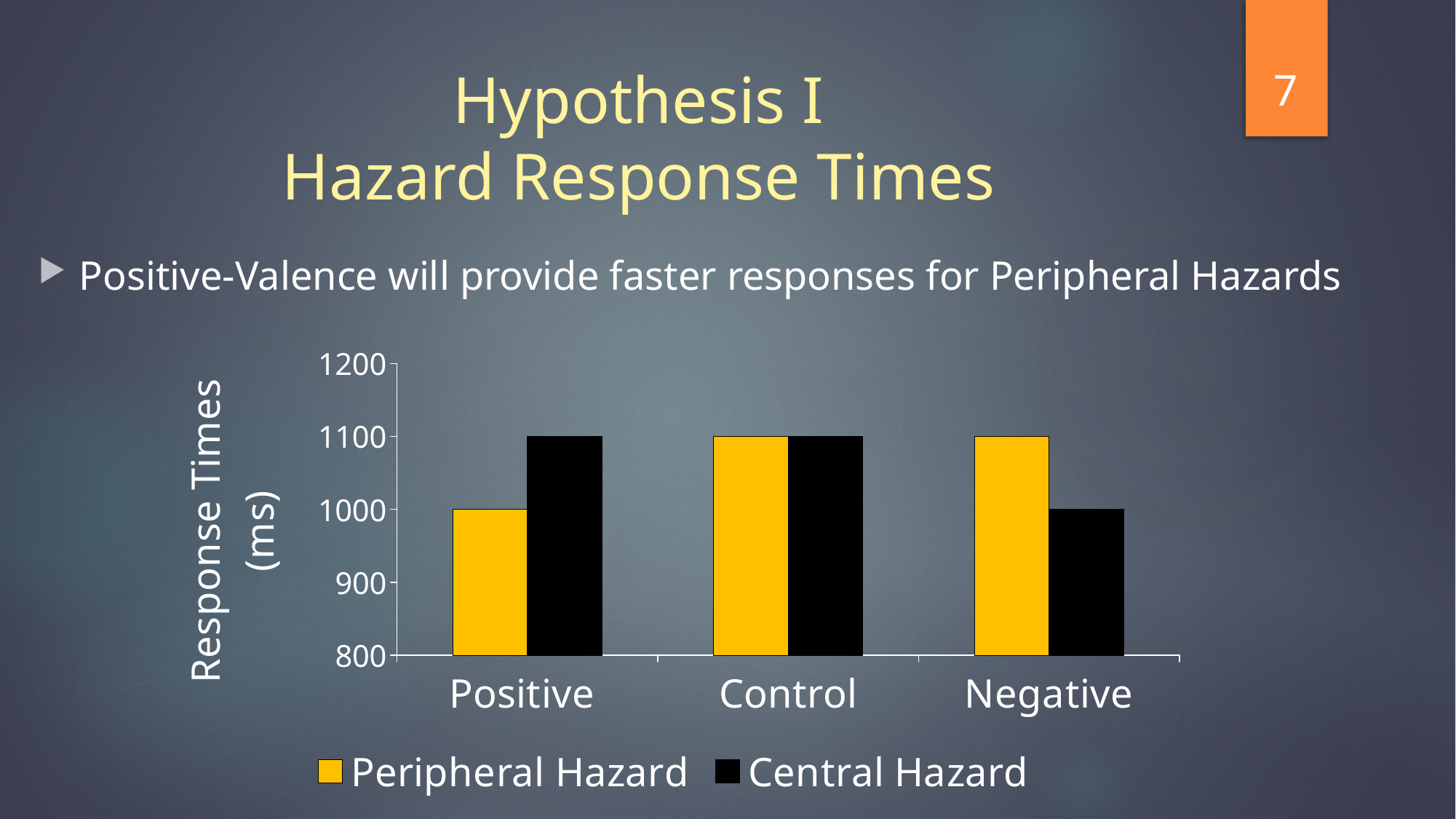
Which condition has the lowest Peripheral Hazard response time? Positive What is the difference between the Central Hazard and Peripheral Hazard response times for the Positive condition? 100 Which condition has the lowest Central Hazard response time? Negative What is the Central Hazard response time for the Negative condition? 1000 How many series does the chart legend list? 2 What is the label of the y axis of the chart? Response Times (ms) What type of chart is shown on the slide? bar chart For the Negative condition, which is larger: the Peripheral Hazard or the Central Hazard response time? Peripheral Hazard What is the Central Hazard response time for the Positive condition? 1100 What is the Peripheral Hazard response time for the Positive condition? 1000 How many categories are shown on the x axis of the chart? 3 What is the Peripheral Hazard response time for the Control condition? 1100